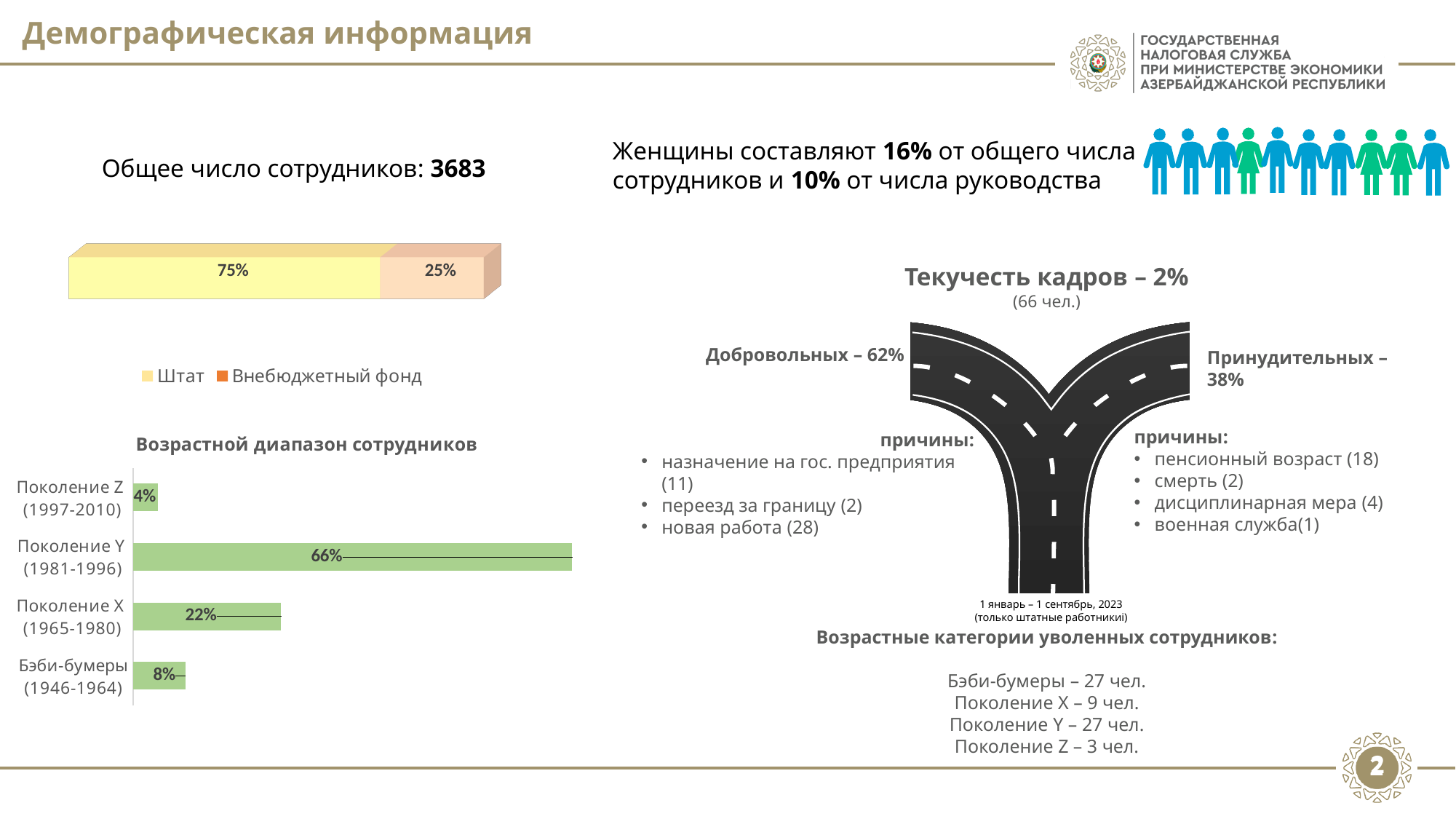
In the 'Возрастной диапазон сотрудников' chart, which generation has the highest share? Поколение Y (1981-1996) How many generation categories are shown in the 'Возрастной диапазон сотрудников' chart? 4 In the 'Возрастной диапазон сотрудников' chart, what is the value for Поколение X (1965-1980)? 22% In the stacked bar chart on the upper left of the slide, what is the value for Внебюджетный фонд? 25% In the 'Возрастной диапазон сотрудников' chart, which generation has the lowest share? Поколение Z (1997-2010) In the 'Возрастной диапазон сотрудников' chart, what is the difference between Поколение Y and Поколение X? 44% In the 'Возрастной диапазон сотрудников' chart, what is the value for Бэби-бумеры (1946-1964)? 8% How many series does the legend of the stacked bar chart on the upper left list? 2 What type of chart is 'Возрастной диапазон сотрудников'? Bar chart In the 'Возрастной диапазон сотрудников' chart, which is larger: Бэби-бумеры or Поколение Z? Бэби-бумеры In the stacked bar chart on the upper left of the slide, what is the value for Штат? 75% In the 'Возрастной диапазон сотрудников' chart, what is the value for Поколение Y (1981-1996)? 66%